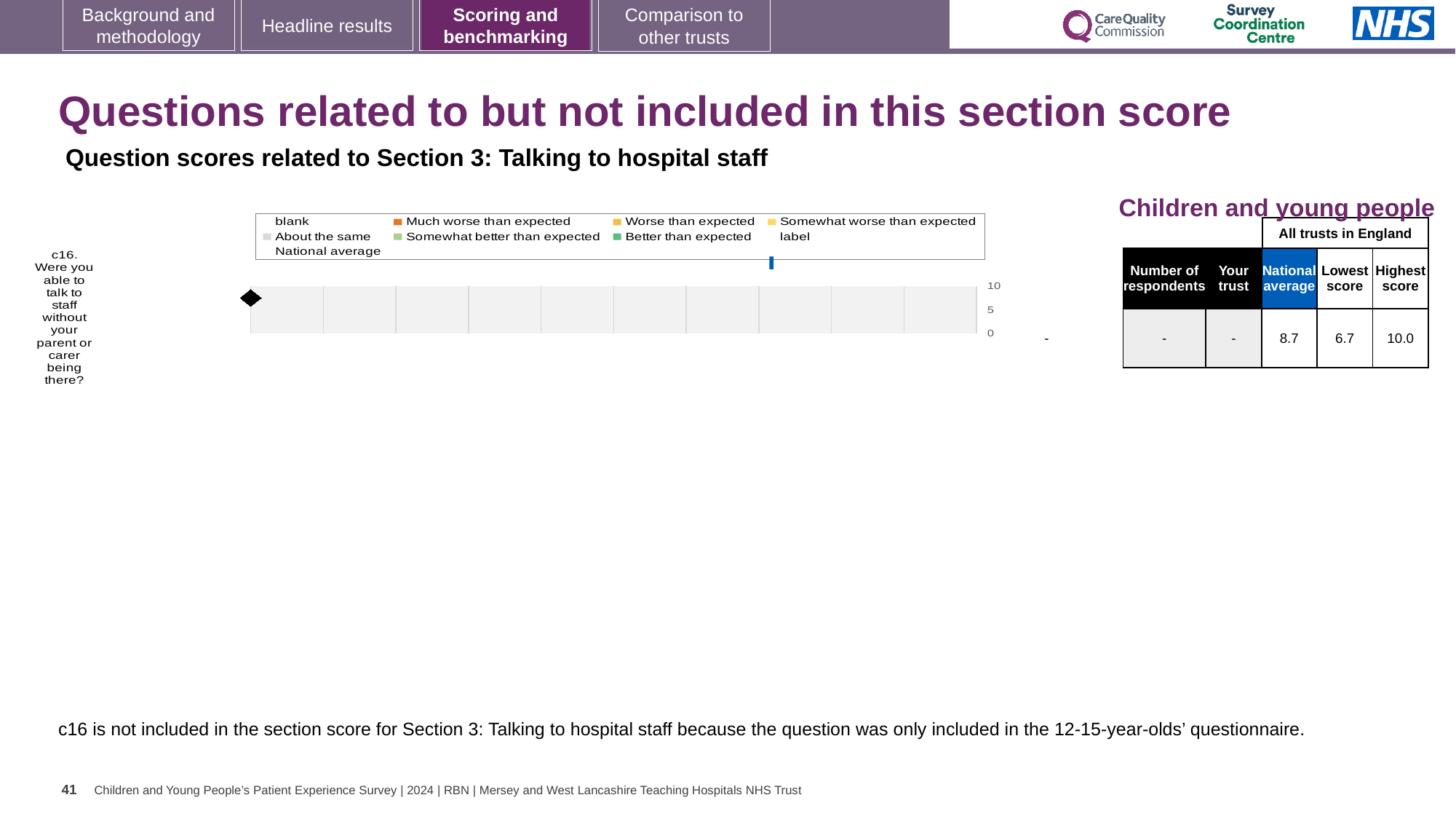
How many question categories are plotted on the chart? 1 According to the table next to the chart, what is the national average score for c16? 8.7 What is the difference between the highest score and the lowest score shown in the table for c16? 3.3 According to the table next to the chart, what is the lowest score across all trusts in England for c16? 6.7 What question is shown as the category label on the chart? c16. Were you able to talk to staff without your parent or carer being there? Which is larger for c16: the national average or the lowest score? National average According to the table next to the chart, what is the highest score across all trusts in England for c16? 10.0 What value is shown for 'Your trust' in the table for c16? - Is the national average score for c16 greater or less than 5? greater What is the highest value shown on the chart's axis? 10